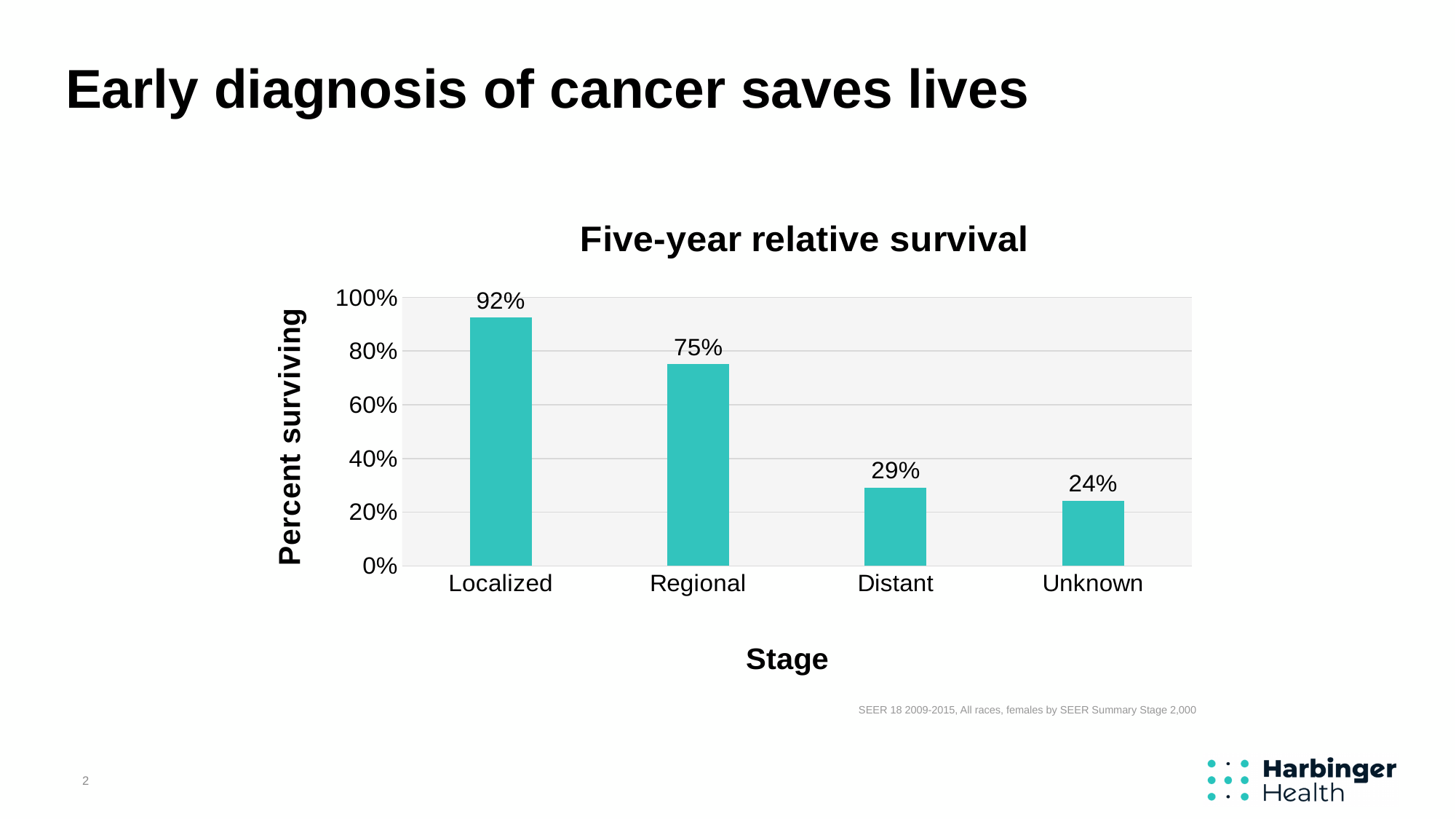
What is the five-year relative survival for the Unknown stage? 24% Which stage has a higher five-year relative survival, Regional or Distant? Regional What is the five-year relative survival for the Localized stage? 92% What kind of chart is shown on the slide? Bar chart Which stage has the lowest five-year relative survival? Unknown What is the difference in five-year relative survival between the Distant and Unknown stages? 5% What is the difference in five-year relative survival between the Localized and Regional stages? 17% How many stages are shown on the x axis of the chart? 4 What is the five-year relative survival for the Distant stage? 29% Which stage has the highest five-year relative survival? Localized What is the five-year relative survival for the Regional stage? 75% What is the title of the chart? Five-year relative survival